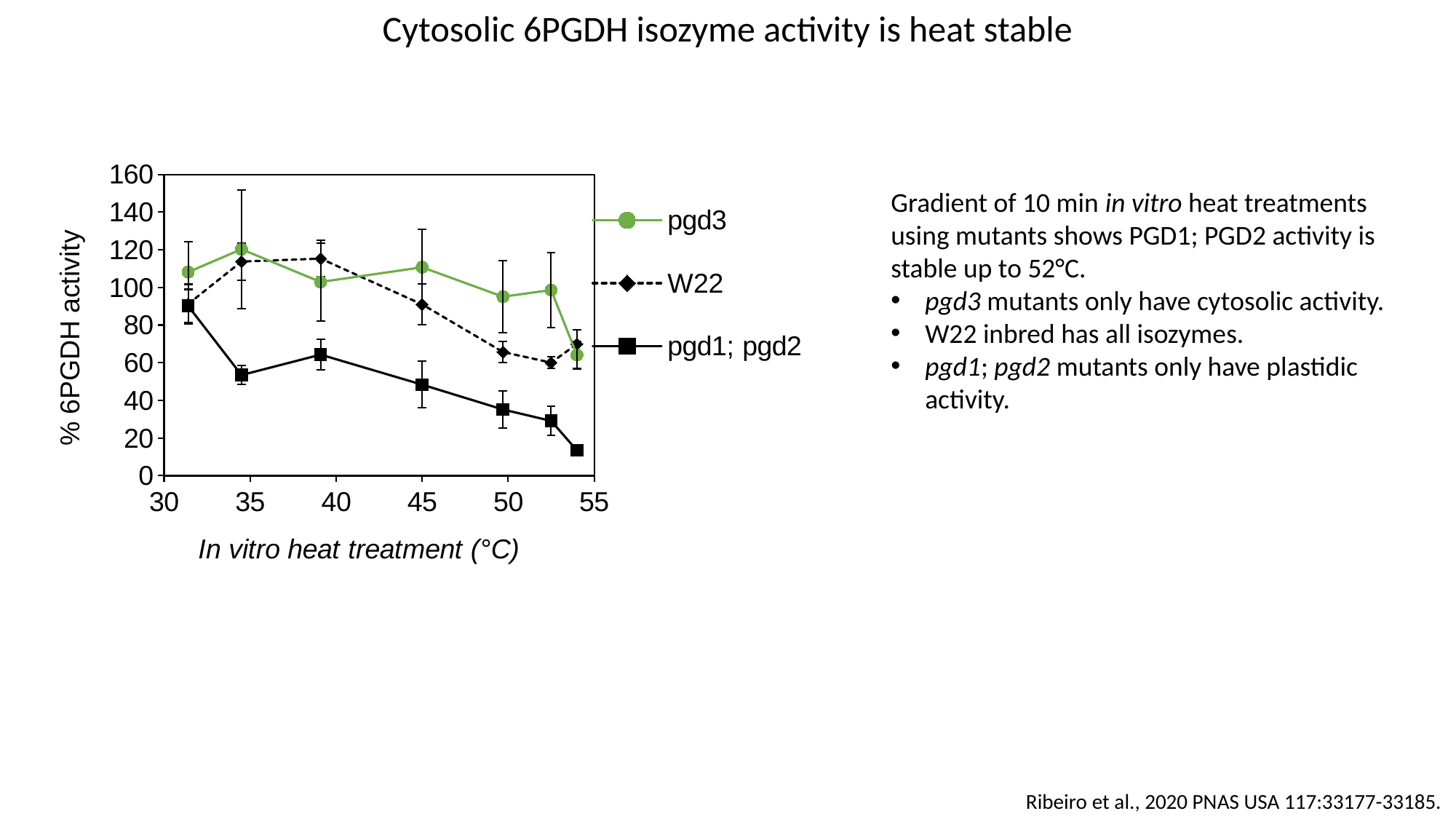
Which series has the lowest values across the temperature range? pgd1; pgd2 Is the value for pgd1; pgd2 at the highest temperature (about 54°C) greater or less than 20? less How many series does the chart's legend list? 3 At about 50°C, which series has the larger value, pgd3 or W22? pgd3 Is the value for W22 at about 39°C greater or less than 100? greater What is the label of the chart's y axis? % 6PGDH activity At about 45°C, which series has the larger value, pgd3 or pgd1; pgd2? pgd3 What kind of chart is shown on the slide? line chart Is the value for pgd3 at about 45°C greater or less than 100? greater Do the values for the pgd1; pgd2 series generally rise or fall as the heat treatment temperature increases? fall How many data points are plotted for the pgd1; pgd2 series? 7